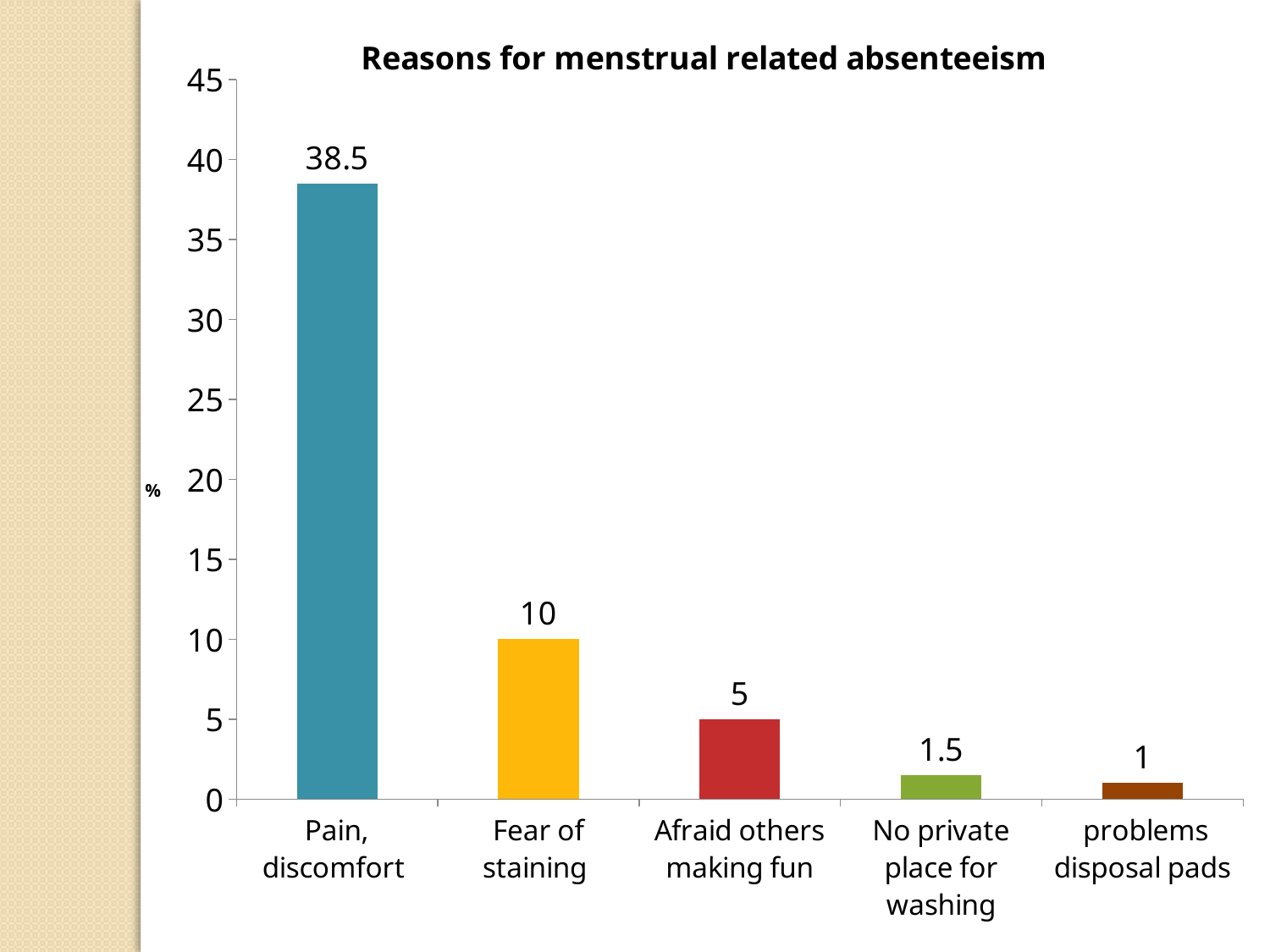
What is the value for No private place for washing? 1.5 What kind of chart is shown? bar chart What is the title of the chart? Reasons for menstrual related absenteeism Which is larger, the value for Afraid others making fun or the value for No private place for washing? Afraid others making fun What is the difference between the values for Pain, discomfort and Fear of staining? 28.5 How many reasons are shown on the chart? 5 What is the value for problems disposal pads? 1 What is the value for Pain, discomfort? 38.5 Which reason has the lowest value? problems disposal pads Which reason has the highest value? Pain, discomfort What is the value for Fear of staining? 10 Is the value for Pain, discomfort greater or less than 35? greater